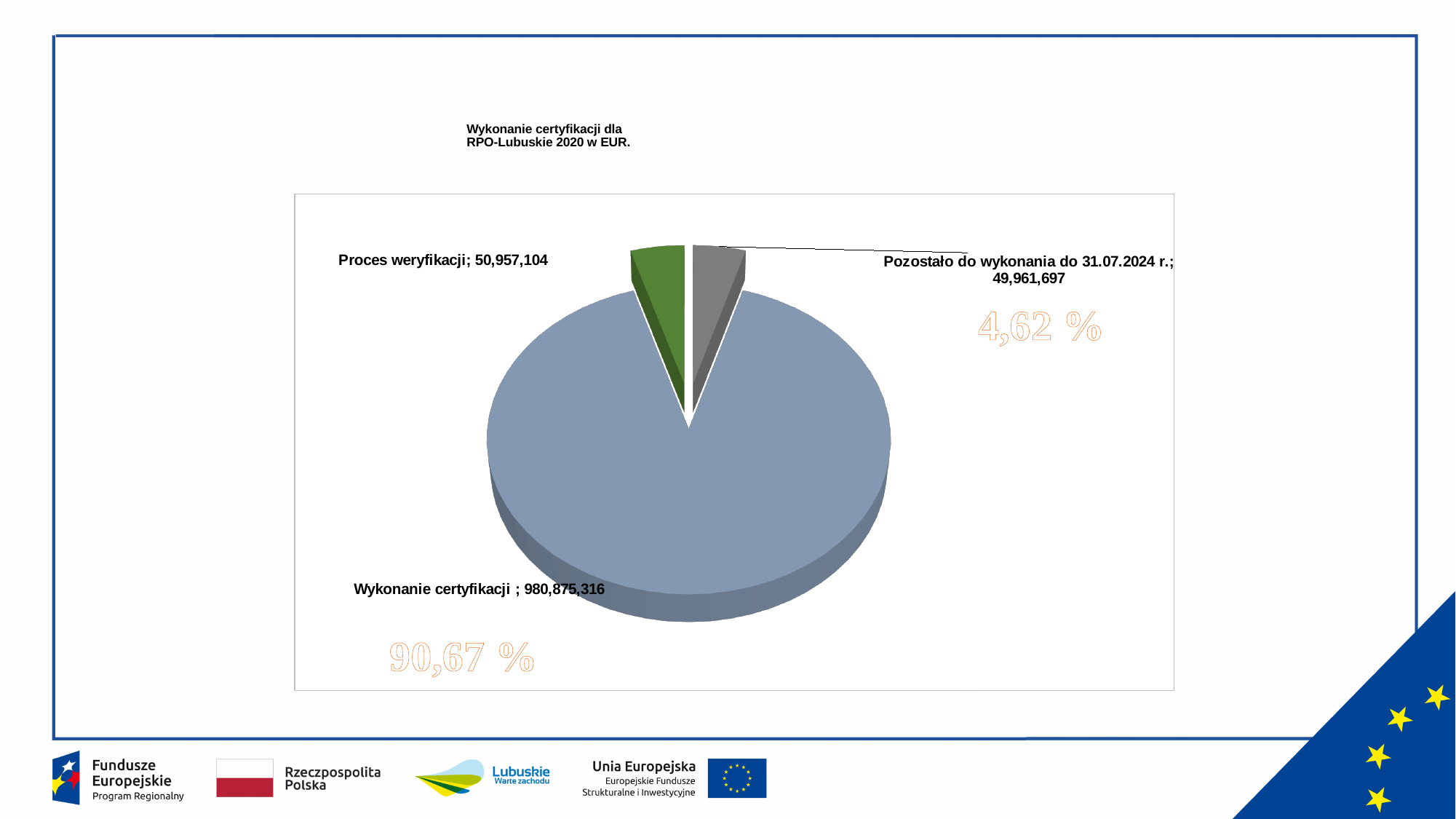
What is the value for Wykonanie certyfikacji? 980,875,316 What kind of chart is shown on the slide? Pie chart What is the title of the chart? Wykonanie certyfikacji dla RPO-Lubuskie 2020 w EUR. What percentage share is shown for Pozostało do wykonania do 31.07.2024 r.? 4,62 % How many slices does the pie chart have? 3 What is the value for Pozostało do wykonania do 31.07.2024 r.? 49,961,697 What is the difference between Proces weryfikacji and Pozostało do wykonania do 31.07.2024 r.? 995,407 What percentage share is shown for Wykonanie certyfikacji? 90,67 % Which category has the smallest value according to the data labels? Pozostało do wykonania do 31.07.2024 r. Which is larger, Proces weryfikacji or Pozostało do wykonania do 31.07.2024 r.? Proces weryfikacji Which category has the largest slice of the pie? Wykonanie certyfikacji What is the value for Proces weryfikacji? 50,957,104